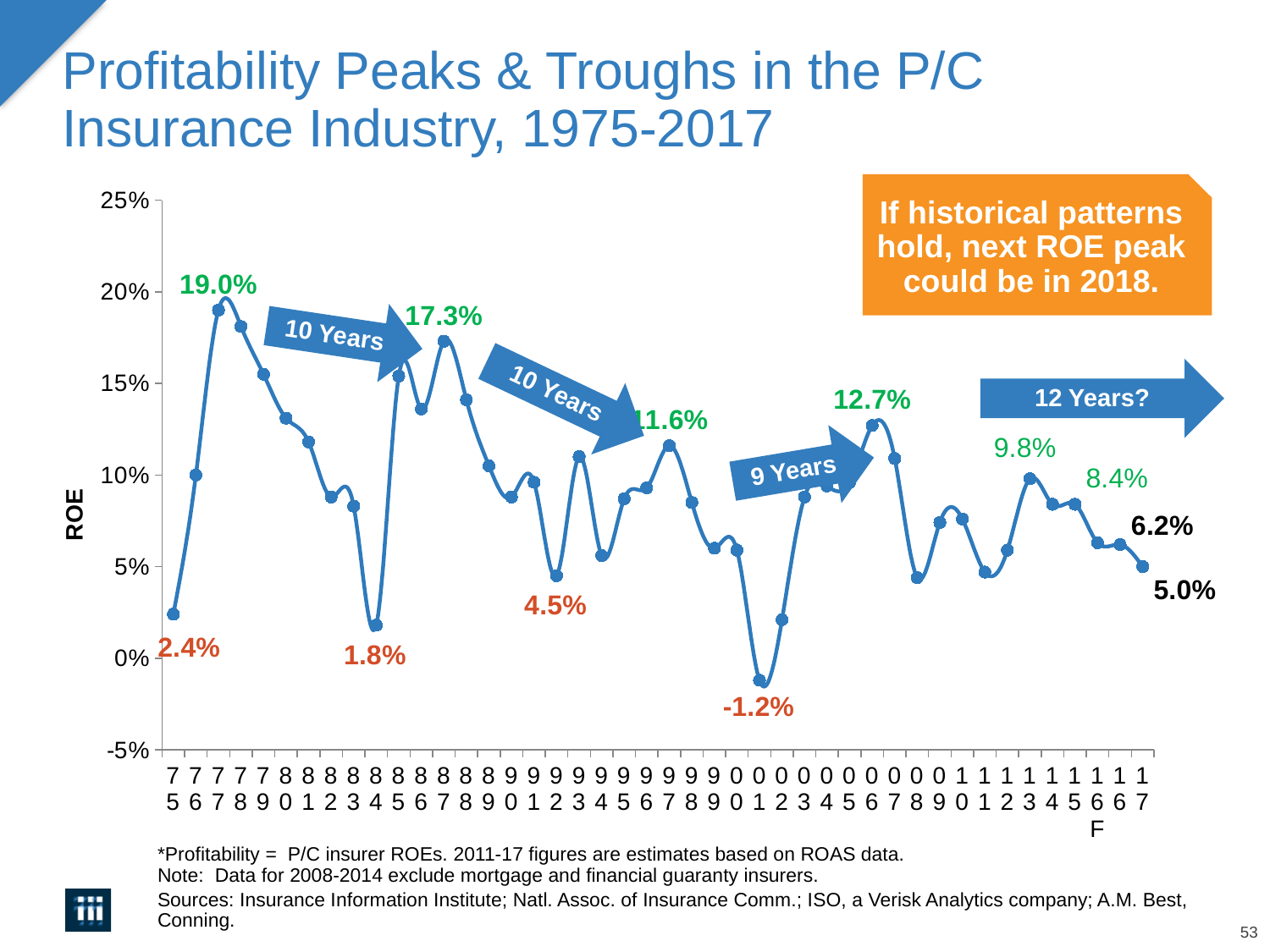
Which year had the higher ROE, 1984 or 1992? 1992 Is the ROE value for 1980 greater or less than 10%? greater What is the ROE value shown for 2017F? 5.0% What kind of chart is shown on the slide? Line chart What was the ROE in 1987? 17.3% In which year was ROE at its highest? 1977 How much higher was the 1977 ROE peak than the 1987 peak? 1.7 percentage points What was the P/C insurance industry ROE in 1977? 19.0% What is the label on the vertical axis of the chart? ROE In which year was ROE at its lowest? 2001 What was the ROE in 2006? 12.7% What was the ROE in 2001? -1.2%